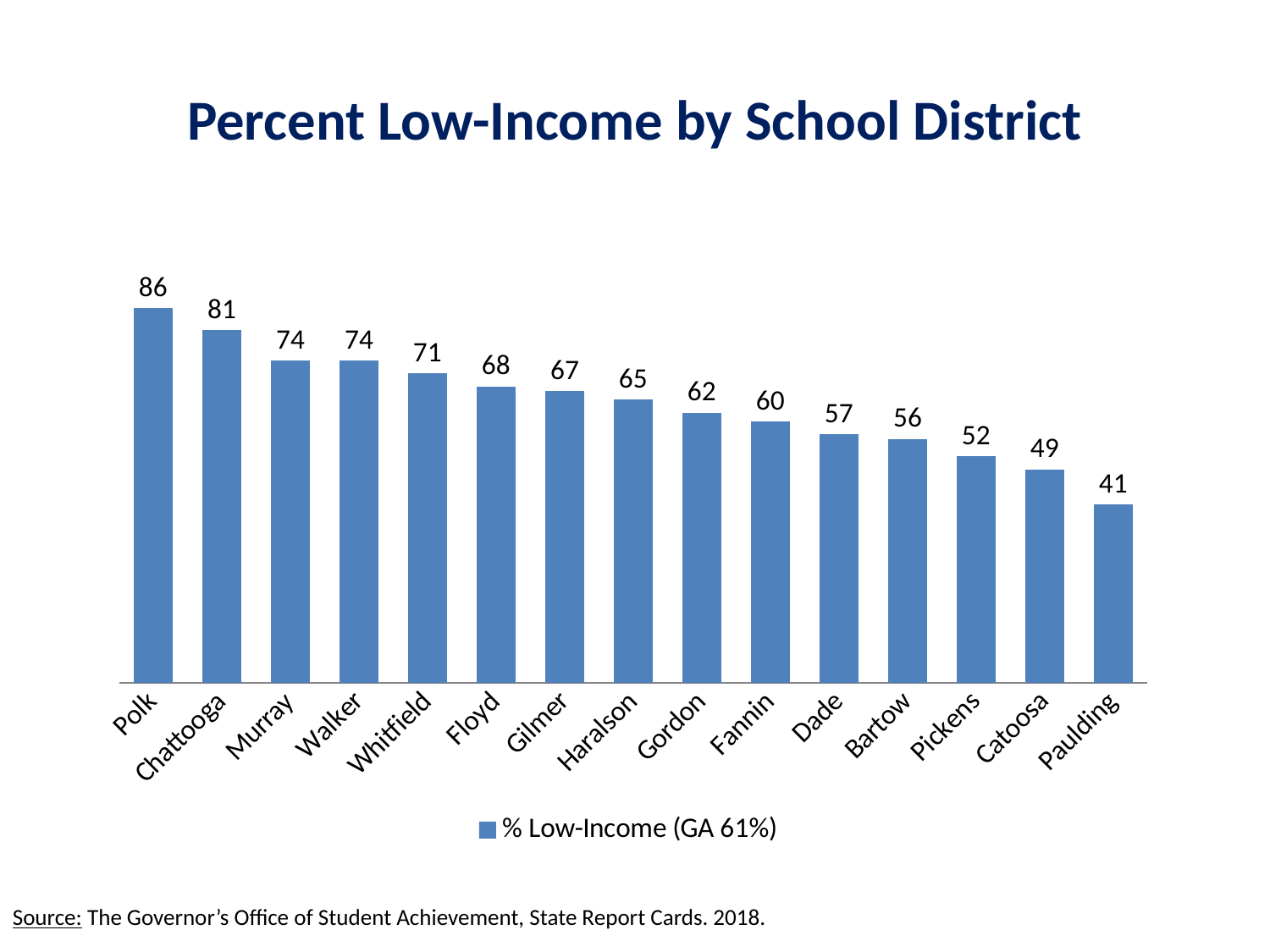
What is the difference between the percent low-income for Chattooga and Whitfield? 10 Which school district has the lowest percent low-income? Paulding What is the percent low-income for Polk? 86 How many series does the legend list? 1 What kind of chart is shown on the slide? Bar chart What is the percent low-income for Catoosa? 49 Which school district has the highest percent low-income? Polk How many school districts are shown in the chart? 15 What is the percent low-income for Gordon? 62 Do the values rise or fall from left to right along the x axis? Fall Which has a higher percent low-income, Floyd or Dade? Floyd What is the difference between the percent low-income for Polk and Paulding? 45